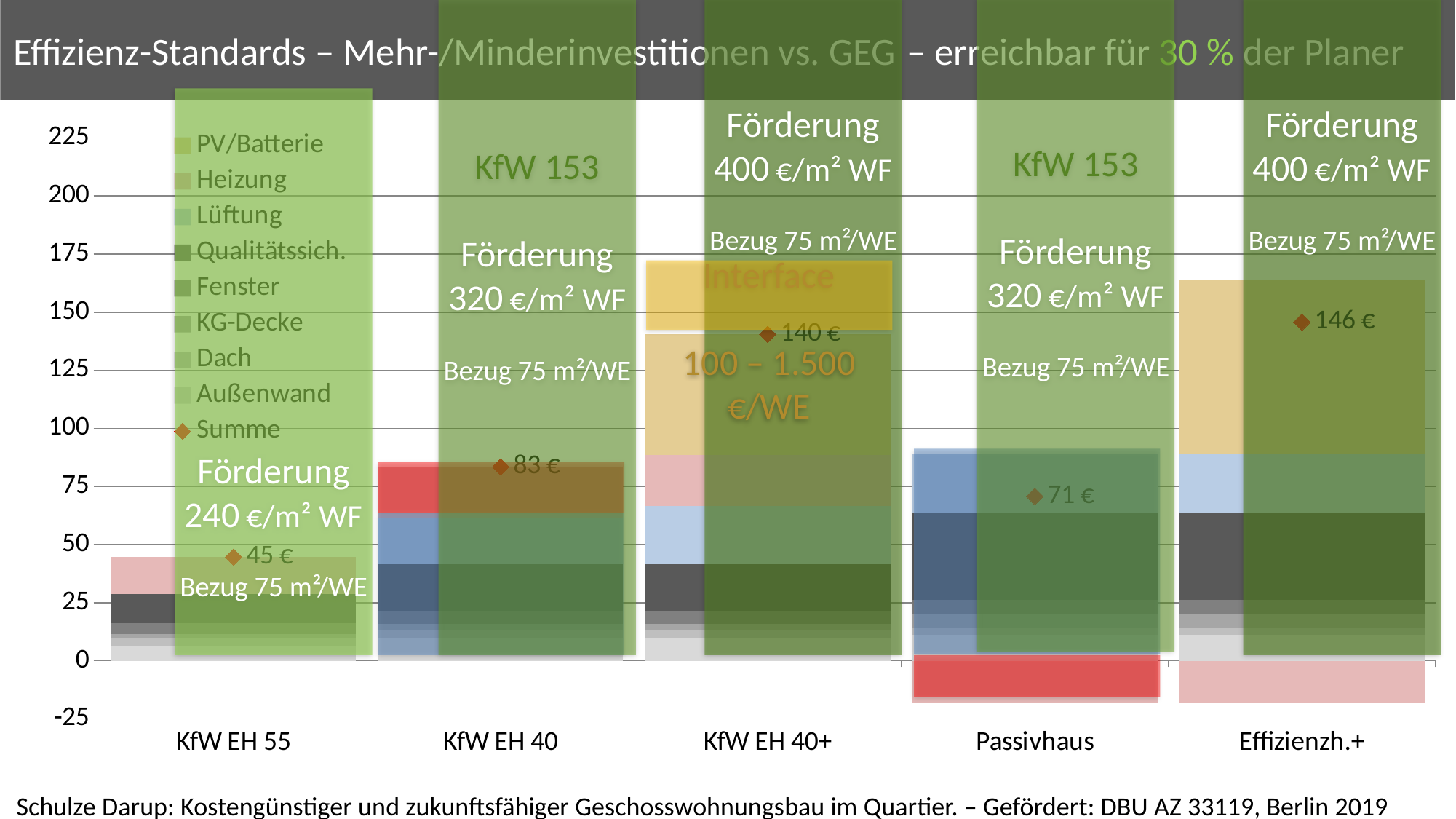
Which category has the highest Summe value? Effizienzh.+ What kind of chart is shown on the slide? Stacked bar chart What is the Summe value for Effizienzh.+? 146 € What is the Summe value for KfW EH 55? 45 € How many series does the legend list? 9 What is the Summe value for KfW EH 40? 83 € How many categories are shown on the x axis? 5 Which category has the lowest Summe value? KfW EH 55 Which has the larger Summe value, KfW EH 40 or Passivhaus? KfW EH 40 What is the difference between the Summe values for KfW EH 40 and KfW EH 55? 38 € What is the Summe value for Passivhaus? 71 € What is the difference between the Summe values for Effizienzh.+ and KfW EH 40+? 6 €